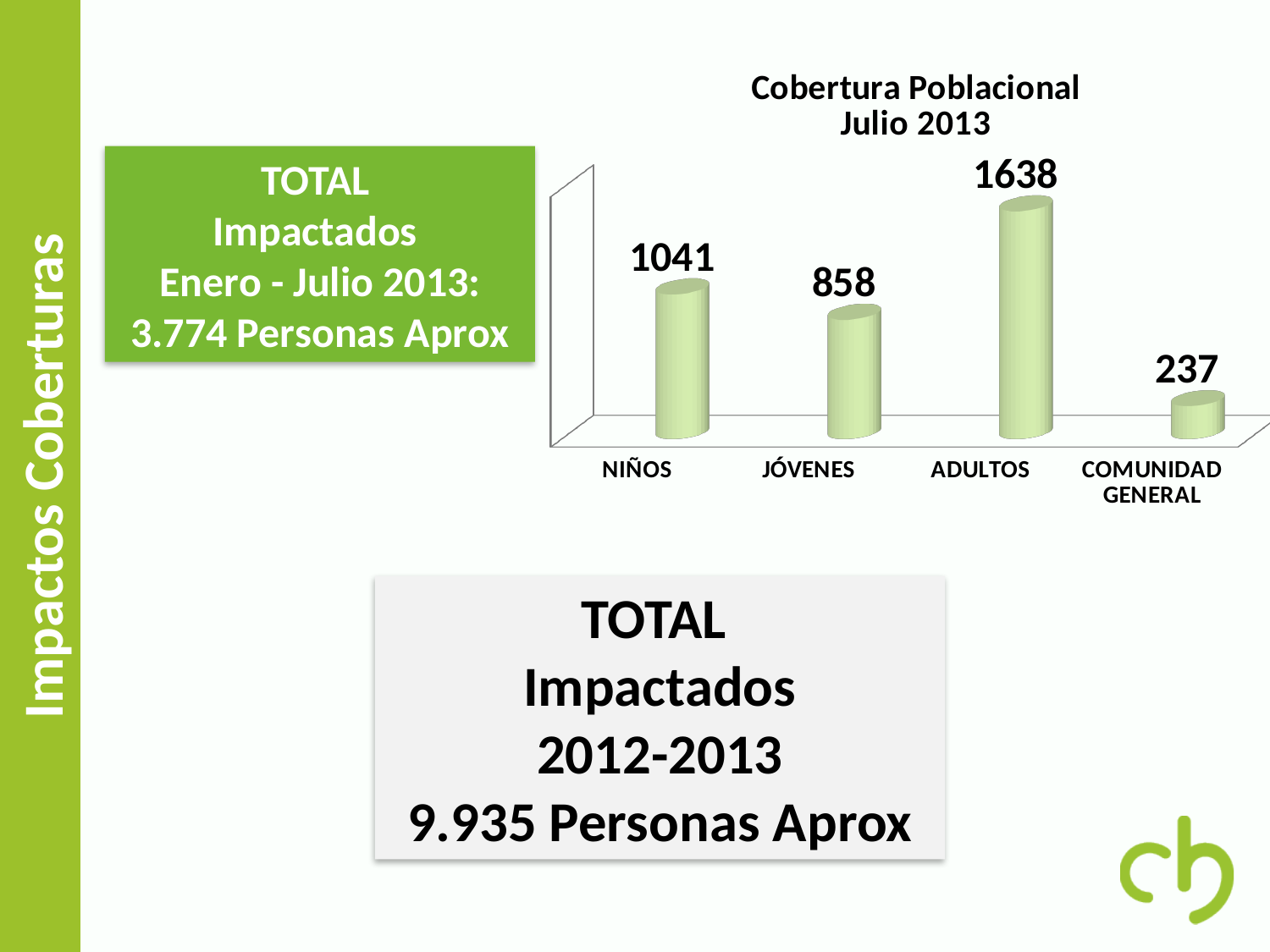
What is the difference between the values for ADULTOS and NIÑOS? 597 How many categories are shown in the chart? 4 Which category has the highest value in the chart? ADULTOS What is the difference between the values for JÓVENES and COMUNIDAD GENERAL? 621 What is the value for NIÑOS in the Cobertura Poblacional Julio 2013 chart? 1041 What is the value for ADULTOS in the chart? 1638 What is the title of the chart? Cobertura Poblacional Julio 2013 What is the value for JÓVENES in the chart? 858 Which category has the lowest value in the chart? COMUNIDAD GENERAL What kind of chart is shown on the slide? Bar chart Which is larger, the value for NIÑOS or the value for JÓVENES? NIÑOS What is the value for COMUNIDAD GENERAL in the chart? 237